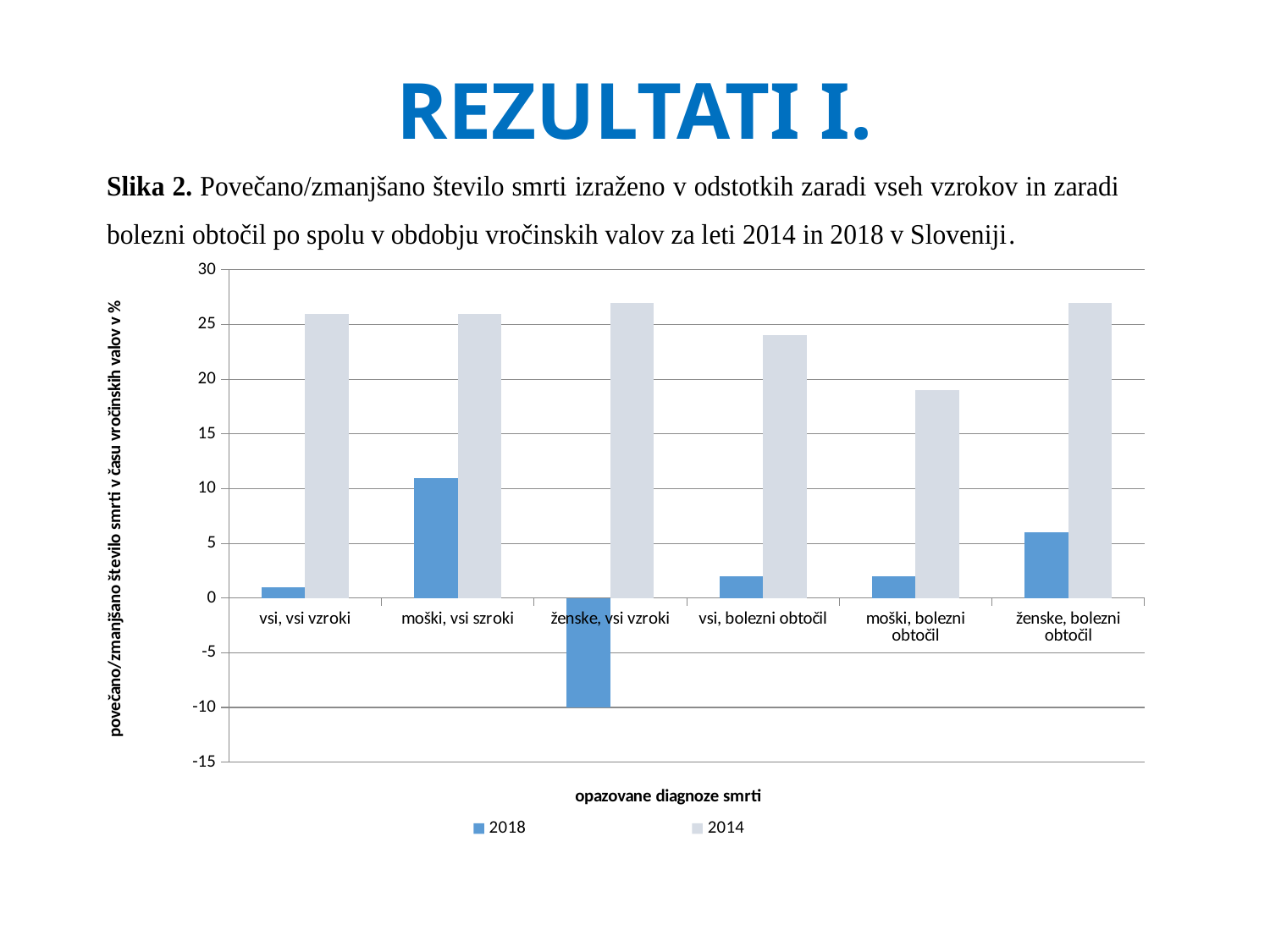
Which category has the highest value for the 2018 series? moški, vsi szroki Is the 2018 value for moški, vsi szroki greater or less than 5? greater How many series does the legend list? 2 What kind of chart is shown on the slide? bar chart What is the label of the x axis? opazovane diagnoze smrti Is the 2018 value for ženske, vsi vzroki greater or less than 0? less Which category has the lowest value for the 2014 series? moški, bolezni obtočil Is the 2014 value for moški, bolezni obtočil greater or less than 20? less How many categories are shown on the x axis? 6 For vsi, bolezni obtočil, which series has the larger value, 2018 or 2014? 2014 Which category has the lowest value for the 2018 series? ženske, vsi vzroki